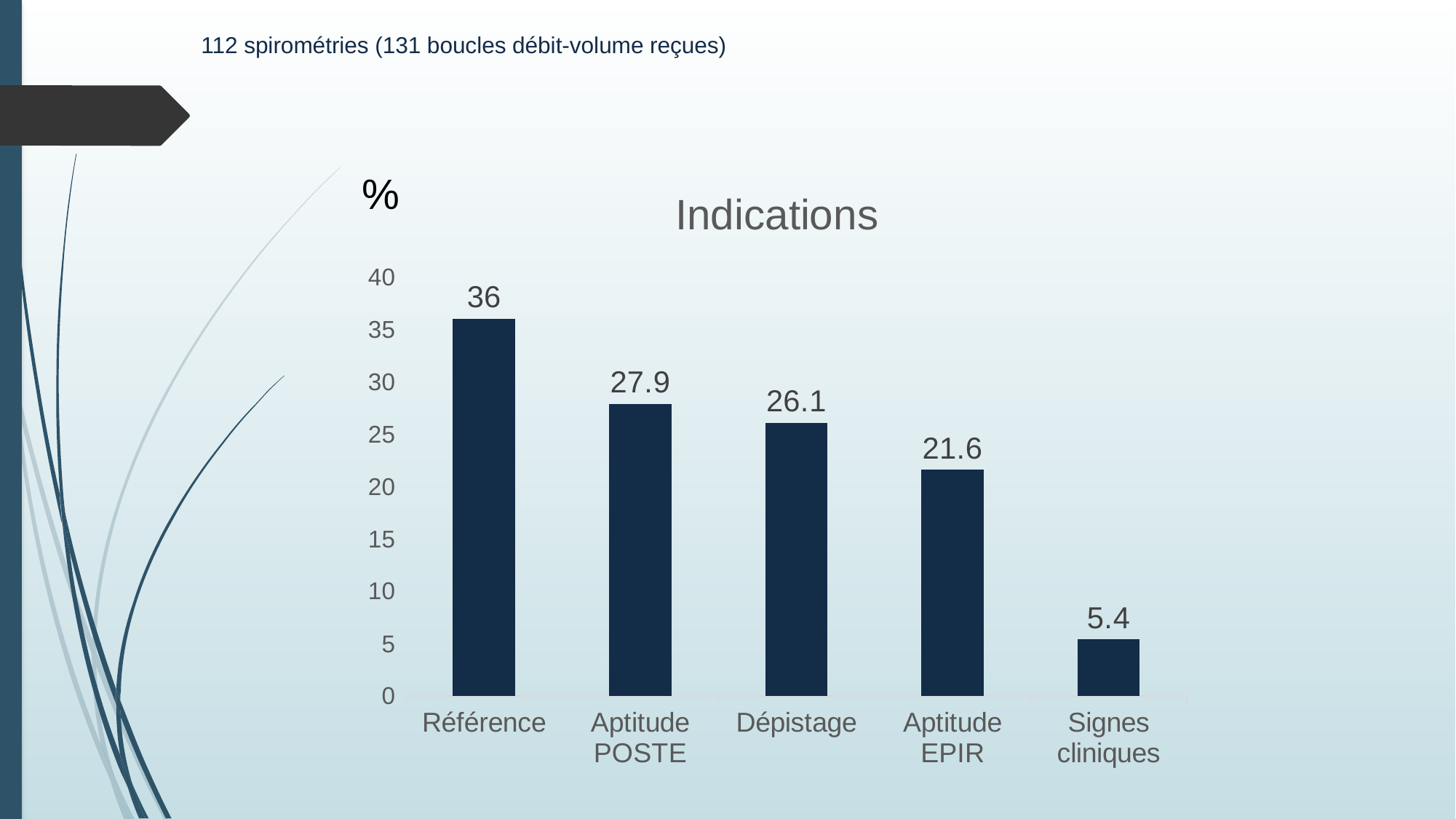
What is the value for Référence? 36 How many categories are shown on the x axis? 5 What kind of chart is shown? bar chart What is the value for Signes cliniques? 5.4 Which is larger, the value for Dépistage or the value for Aptitude EPIR? Dépistage Do the values rise or fall from left to right along the x axis? fall What is the difference between the values for Référence and Aptitude EPIR? 14.4 What is the title of the chart? Indications What is the value for Aptitude POSTE? 27.9 Which category has the lowest value? Signes cliniques Which category has the highest value? Référence Is the value for Dépistage greater or less than 25? greater